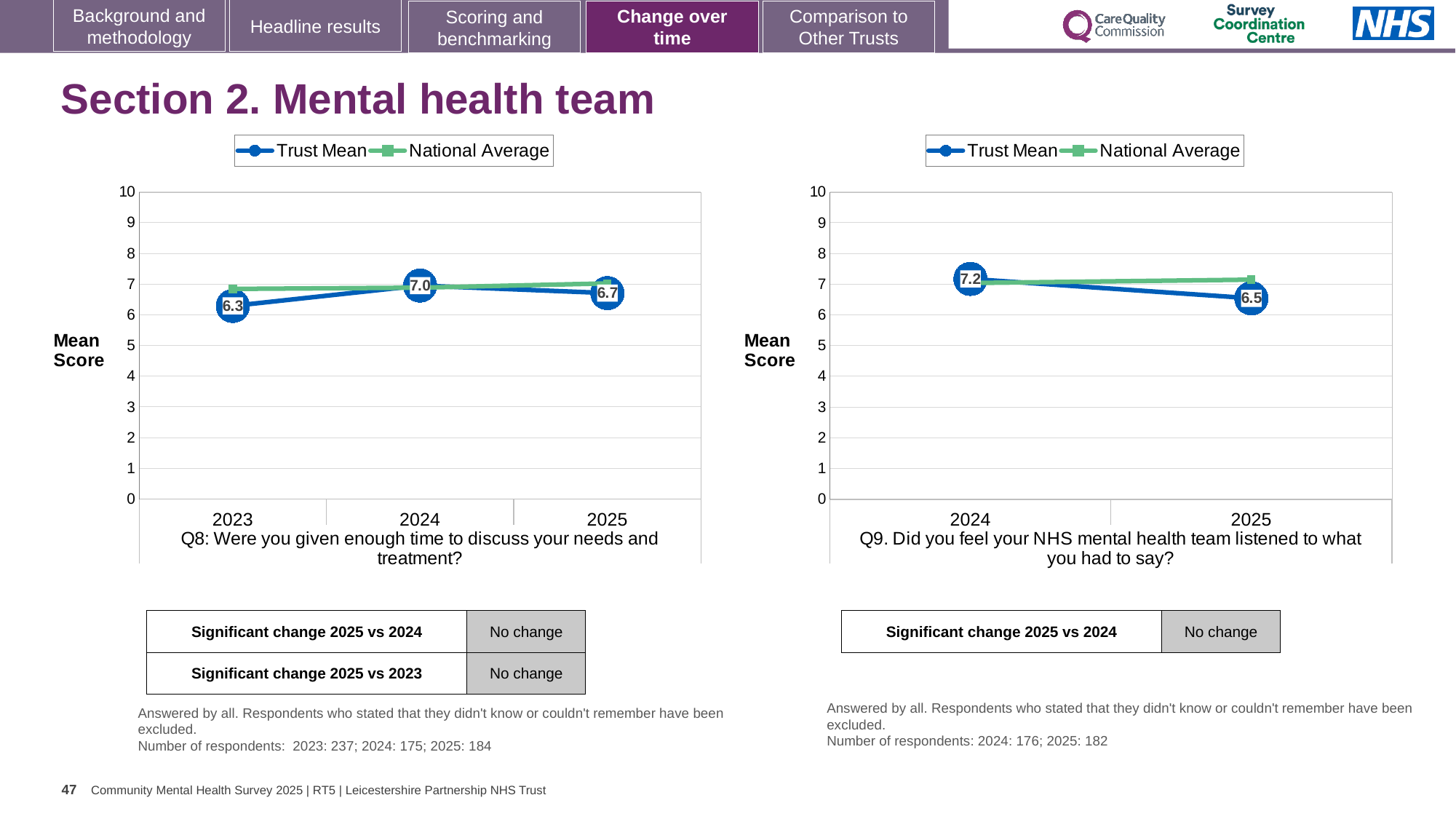
How many series does the legend of the right chart (Q9) list? 2 In the right chart (Q9), does the Trust Mean rise or fall from 2024 to 2025? fall In the left chart (Q8), is the Trust Mean for 2025 larger or smaller than the Trust Mean for 2023? larger In the left chart (Q8), which year has the lowest Trust Mean? 2023 In the left chart (Q8), which year has the highest Trust Mean? 2024 In the right chart (Q9), what is the Trust Mean for 2025? 6.5 In the right chart (Q9), is the National Average for 2025 greater or less than 5? greater How many years are shown on the x axis of the left chart (Q8)? 3 What kind of chart is the right chart (Q9)? line chart In the left chart (Q8), what is the Trust Mean for 2024? 7.0 In the left chart (Q8), what is the Trust Mean for 2023? 6.3 In the right chart (Q9), what is the difference between the Trust Mean for 2024 and 2025? 0.7